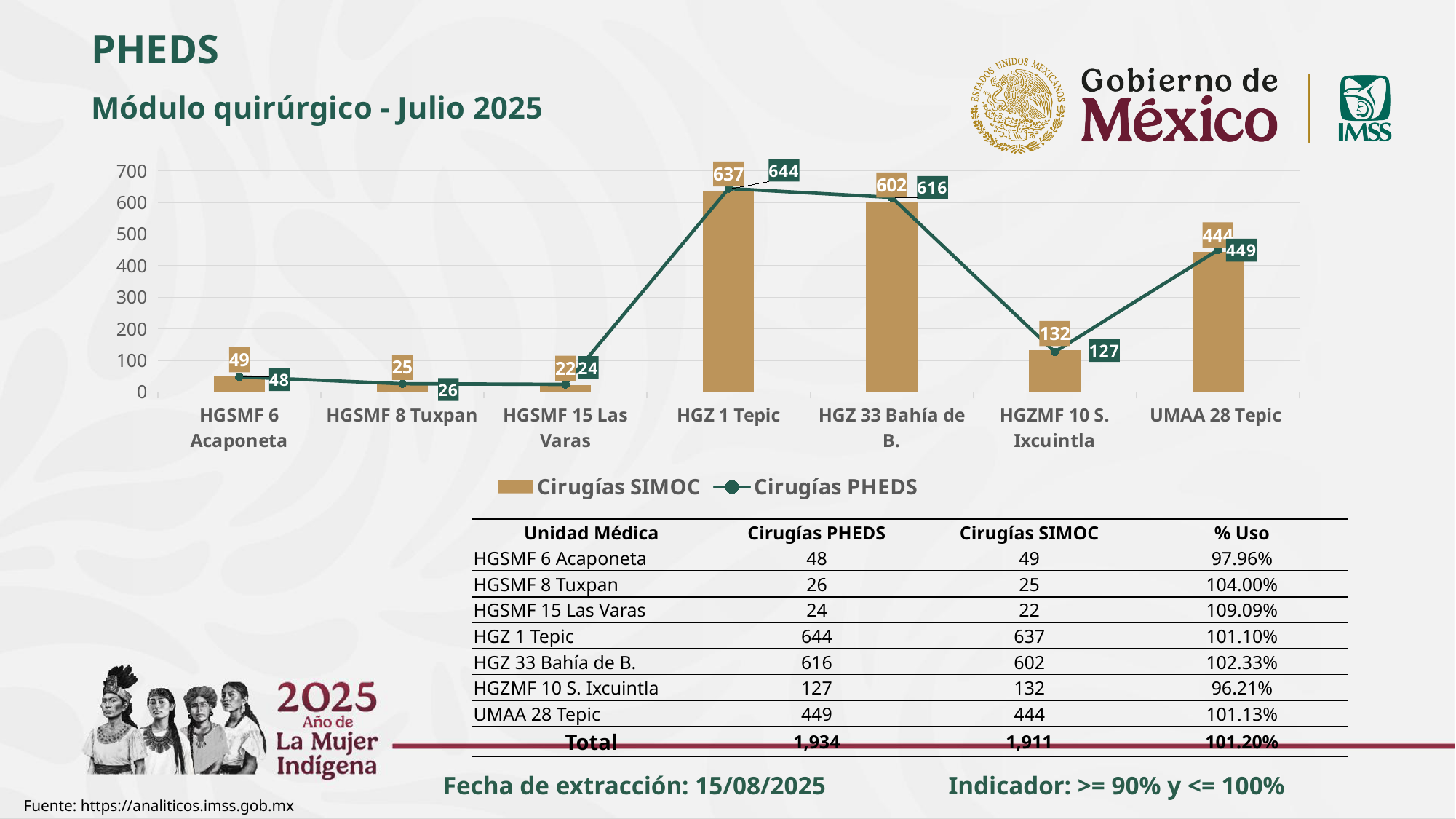
What kind of chart is used to show Cirugías SIMOC? Bar chart How many medical units are shown on the x axis of the chart? 7 What is the difference between Cirugías PHEDS and Cirugías SIMOC for HGZ 33 Bahía de B.? 14 What is the Cirugías PHEDS value for HGZMF 10 S. Ixcuintla? 127 Which is larger for UMAA 28 Tepic, Cirugías SIMOC or Cirugías PHEDS? Cirugías PHEDS Is the Cirugías SIMOC value for HGZMF 10 S. Ixcuintla greater or less than 200? less Which unit has the highest Cirugías SIMOC value? HGZ 1 Tepic What is the Cirugías SIMOC value for HGZ 1 Tepic? 637 How many series does the chart legend list? 2 Which unit has the lowest Cirugías PHEDS value? HGSMF 15 Las Varas Which series is drawn as a line in the chart? Cirugías PHEDS What is the Cirugías PHEDS value for HGZ 33 Bahía de B.? 616